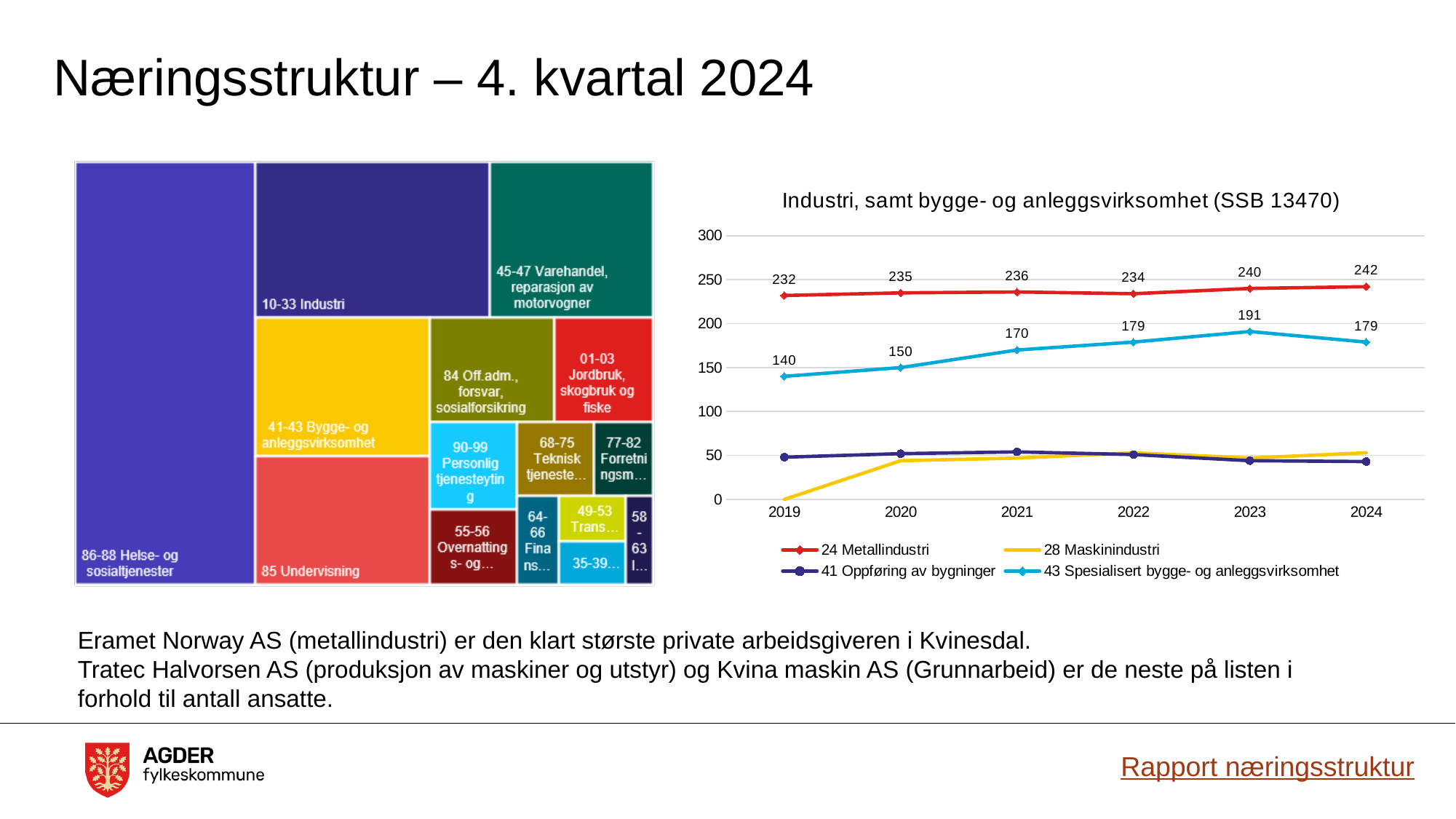
In the line chart on the right, what is the value for 43 Spesialisert bygge- og anleggsvirksomhet in 2021? 170 In the line chart titled "Industri, samt bygge- og anleggsvirksomhet (SSB 13470)", what is the value for 24 Metallindustri in 2024? 242 In the line chart on the right, by how much did 43 Spesialisert bygge- og anleggsvirksomhet increase from 2019 to 2023? 51 In the line chart on the right, what is the value for 24 Metallindustri in 2019? 232 In the line chart on the right, what is the difference between the 24 Metallindustri value and the 43 Spesialisert bygge- og anleggsvirksomhet value in 2024? 63 In the line chart on the right, which series has the higher value in 2022: 24 Metallindustri or 43 Spesialisert bygge- og anleggsvirksomhet? 24 Metallindustri In the line chart on the right, in which year does 43 Spesialisert bygge- og anleggsvirksomhet reach its highest value? 2023 In the line chart on the right, in which year is the value for 24 Metallindustri lowest? 2019 In the line chart on the right, is the value for 28 Maskinindustri in 2019 greater or less than 50? less In the line chart on the right, how many series does the legend list? 4 In the line chart on the right, how many years are shown on the x axis? 6 What kind of chart is the chart on the right side of the slide? Line chart